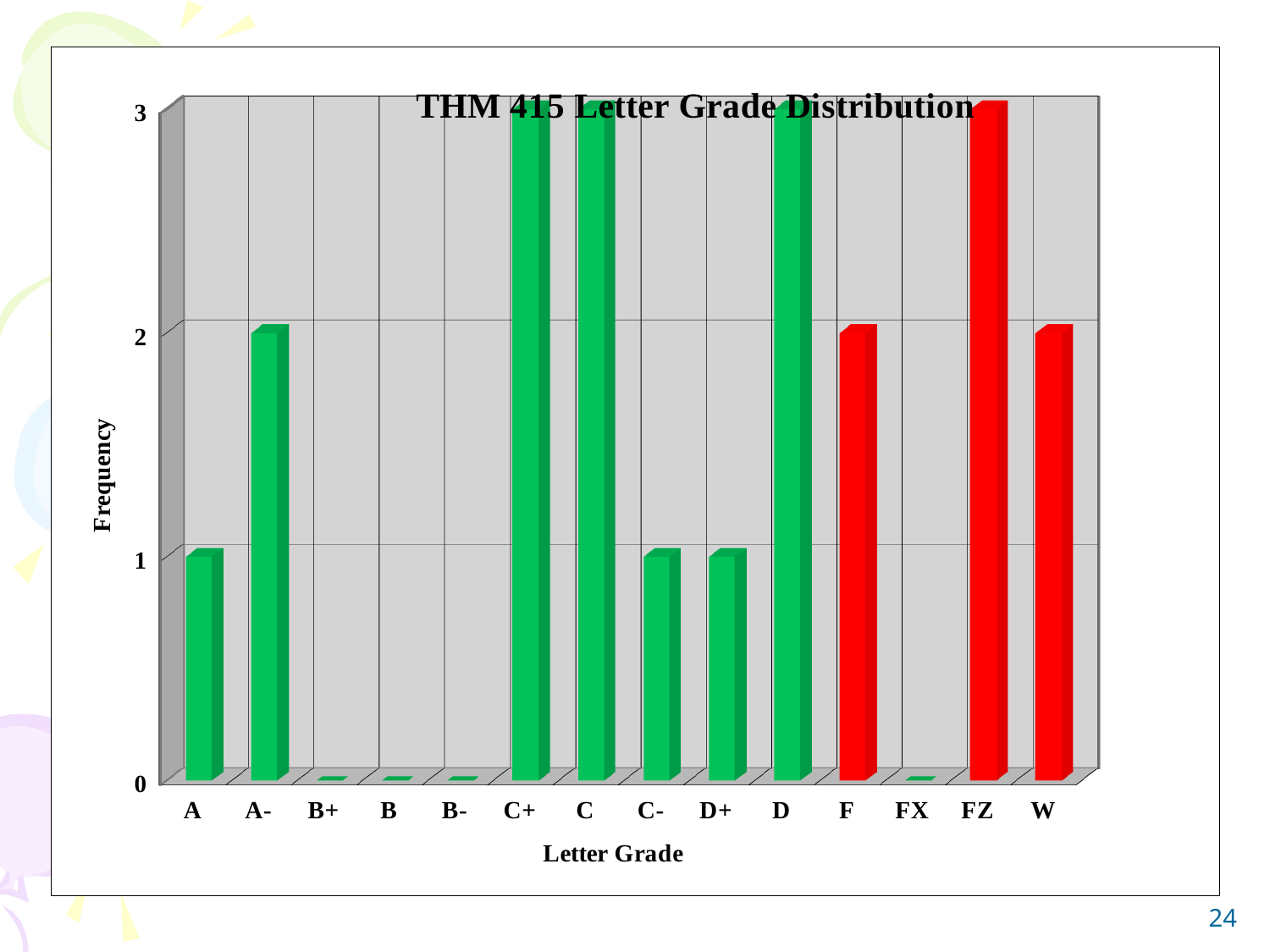
Is the frequency for F greater or less than 1? greater How many letter grade categories are shown on the x axis? 14 What is the difference between the frequency for A- and the frequency for A? 1 What is the frequency for letter grade A? 1 What kind of chart is shown on the slide? bar chart What is the frequency for letter grade C+? 3 What is the frequency for letter grade A-? 2 What is the frequency for letter grade B? 0 What is the frequency for letter grade W? 2 What is the title of the chart? THM 415 Letter Grade Distribution Which has a higher frequency, D or D+? D What is the frequency for letter grade FZ? 3